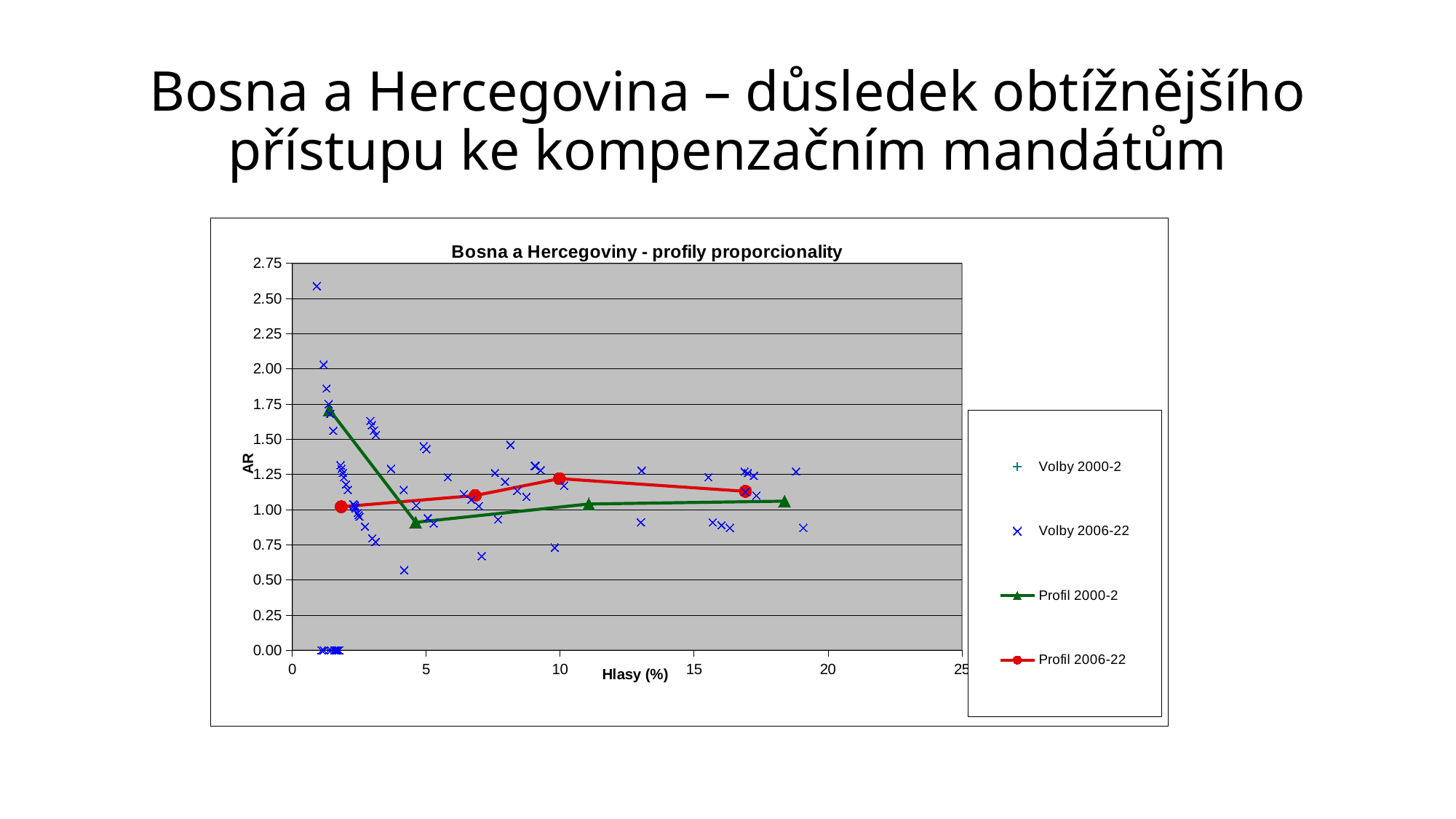
Does the Profil 2000-2 line rise or fall between its first and second points? fall Is the AR value of the first (leftmost) point of the Profil 2000-2 line greater or less than 1.50? greater Is the AR value of the Profil 2006-22 point at about 10% of votes greater or less than 1.00? greater What is the title of the chart? Bosna a Hercegoviny - profily proporcionality How many marked points does the Profil 2000-2 line have? 4 Is the AR value of the second point of the Profil 2000-2 line (near 5% of votes) greater or less than 1.00? less How many series does the legend list? 4 What is the label of the x axis? Hlasy (%) What kind of chart is shown on the slide? scatter chart How many marked points does the Profil 2006-22 line have? 4 Which line has the higher AR value at its leftmost point, Profil 2000-2 or Profil 2006-22? Profil 2000-2